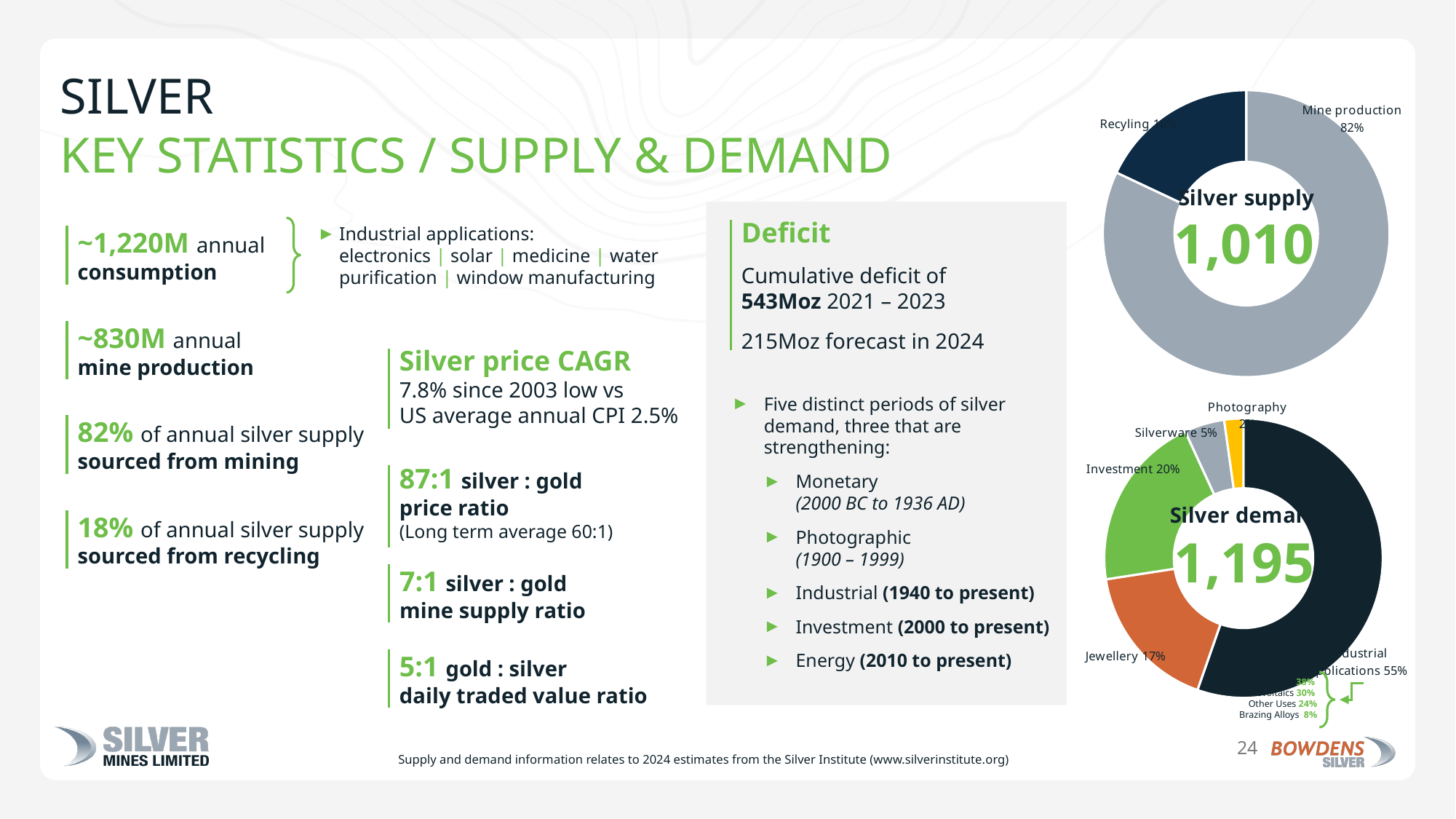
In the Silver supply chart, which segment is the largest? Mine production What total value is shown in the centre of the Silver demand chart? 1,195 In the Silver demand chart, what share is Investment? 20% What kind of chart is the Silver supply chart? Doughnut (pie) chart In the Silver demand chart, what share is Industrial applications? 55% In the Silver demand chart, which segment is the smallest? Photography What total value is shown in the centre of the Silver supply chart? 1,010 In the Silver demand chart, what share is Silverware? 5% In the Silver supply chart, what share of supply comes from mine production? 82% In the Silver demand chart, how many percentage points larger is Investment than Jewellery? 3 percentage points In the Silver demand chart, what share is Jewellery? 17% In the Silver supply chart, what share of supply comes from recycling? 18%